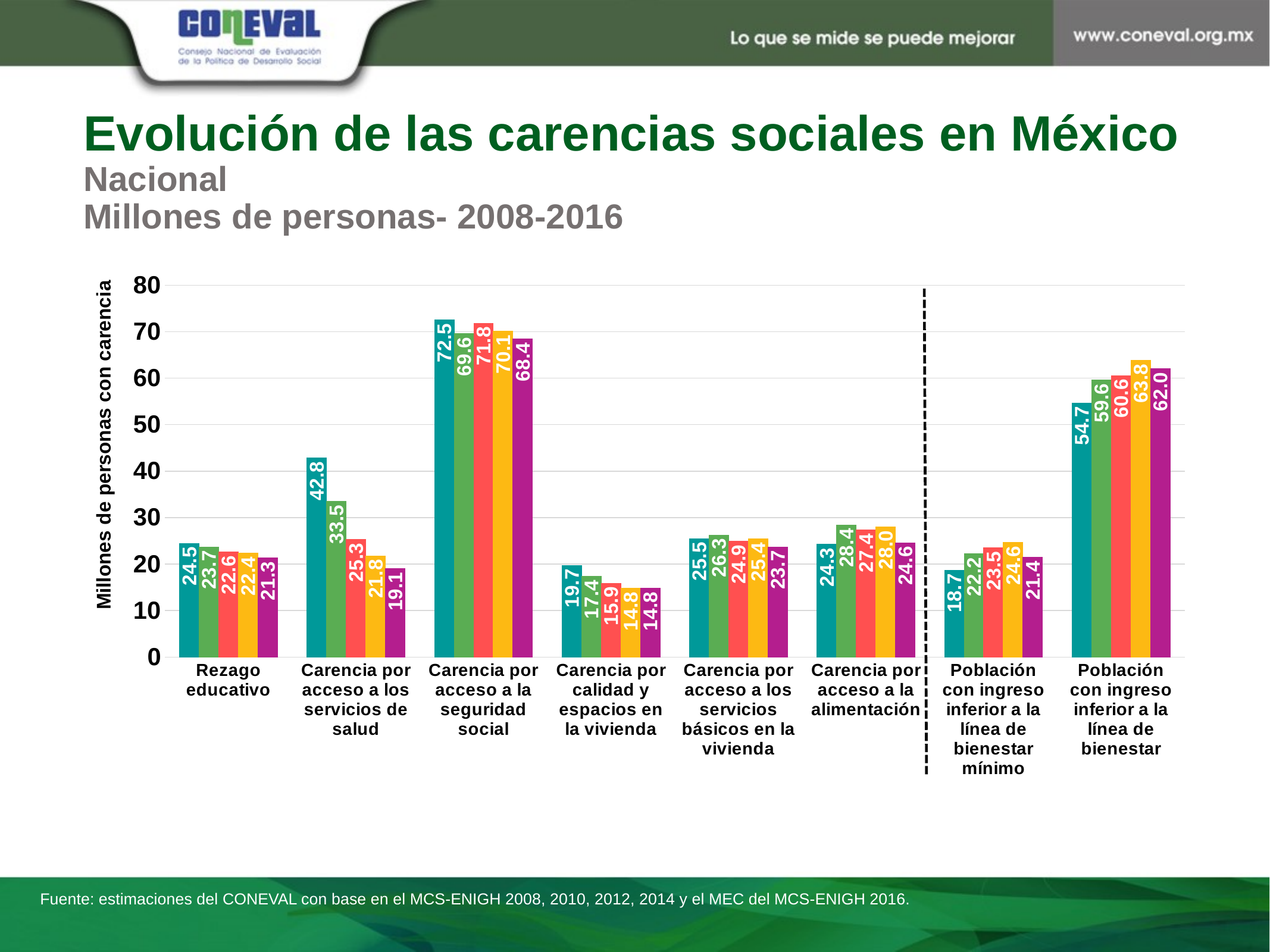
What type of chart is shown on the slide? bar chart Do the bars for 'Carencia por acceso a los servicios de salud' rise or fall from left to right? fall What is the value of the first (leftmost, teal) bar for 'Carencia por acceso a la seguridad social'? 72.5 Which category has the lowest bar in the chart? Carencia por calidad y espacios en la vivienda How many bars are plotted for each category in the chart? 5 What is the label of the y axis of the chart? Millones de personas con carencia Which category has the highest bar in the chart? Carencia por acceso a la seguridad social What is the difference between the first (teal) bar and the last (purple) bar for 'Carencia por acceso a los servicios de salud'? 23.7 What is the value of the last (rightmost, purple) bar for 'Carencia por acceso a los servicios de salud'? 19.1 How many categories are shown along the x axis of the chart? 8 Which is larger: the first (teal) bar for 'Rezago educativo' or the first (teal) bar for 'Población con ingreso inferior a la línea de bienestar mínimo'? Rezago educativo What is the value of the yellow (fourth) bar for 'Población con ingreso inferior a la línea de bienestar'? 63.8